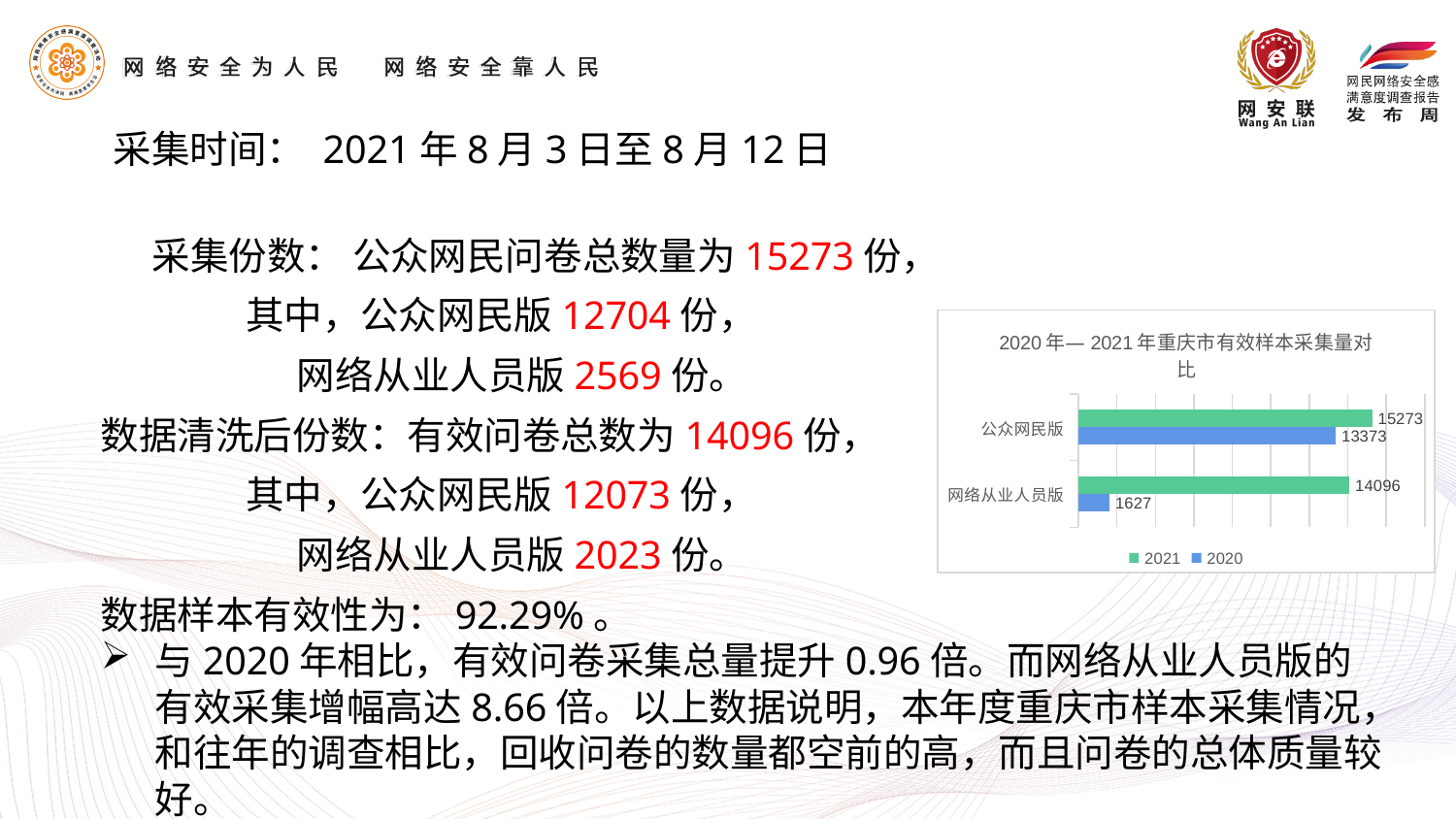
Which category has the lowest value in the chart across both series? 网络从业人员版 (2020) What is the title of the chart on the slide? 2020年—2021年重庆市有效样本采集量对比 Which colour represents the 2021 series in the chart? green What is the 2020 value for 公众网民版 in the chart? 13373 How many categories are shown on the chart's vertical axis? 2 What is the 2021 value for 网络从业人员版 in the chart? 14096 What type of chart is shown on the slide? bar chart How many series does the chart legend list? 2 What is the 2020 value for 网络从业人员版 in the chart? 1627 Which is larger in the chart: the 2020 value for 公众网民版 or the 2020 value for 网络从业人员版? 公众网民版 What is the 2021 value for 公众网民版 in the chart? 15273 What is the difference between the 2021 and 2020 values for 网络从业人员版? 12469